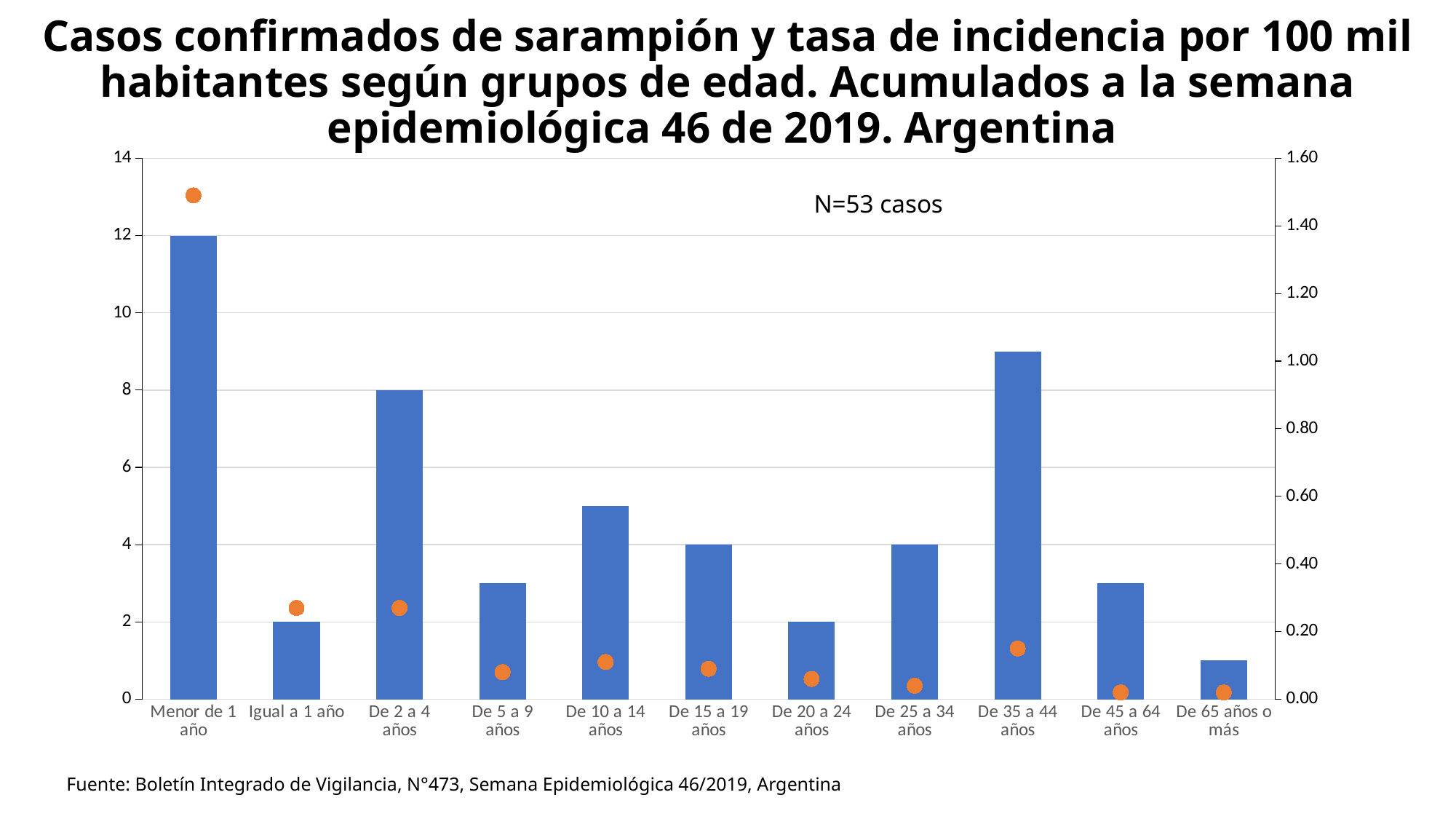
Is the bar for De 35 a 44 años greater or less than 8 on the left axis? greater Which age group has the highest bar of confirmed cases? Menor de 1 año Which has more confirmed cases, De 2 a 4 años or De 20 a 24 años? De 2 a 4 años How many confirmed cases does the bar for De 2 a 4 años reach on the left axis? 8 What total number of cases (N) is stated on the chart? N=53 casos How many confirmed cases does the bar for Menor de 1 año reach on the left axis? 12 What is the difference in confirmed cases between Menor de 1 año and De 2 a 4 años? 4 How many confirmed cases does the bar for Igual a 1 año reach on the left axis? 2 Which age group has the lowest bar of confirmed cases? De 65 años o más Is the orange incidence-rate marker for Menor de 1 año greater or less than 1.40 on the right axis? greater How many age groups are shown on the x axis? 11 What kind of chart is used to show the confirmed cases by age group? bar chart